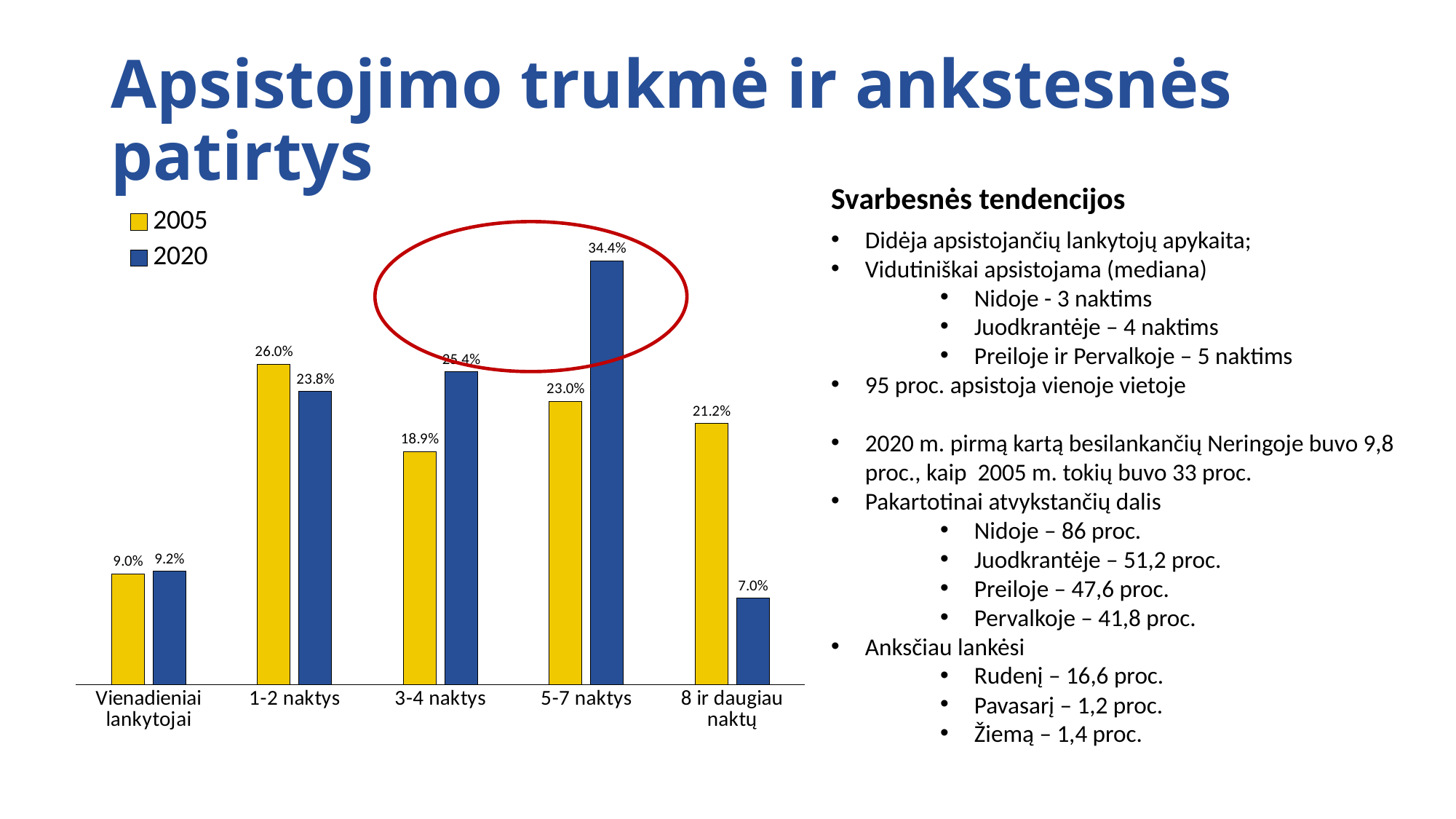
What is the difference between the 2020 and 2005 values for 5-7 naktys? 11.4% What is the 2005 value for 1-2 naktys? 26.0% How many series does the legend list? 2 Which category has the highest 2020 value? 5-7 naktys What is the 2020 value for 8 ir daugiau naktų? 7.0% What is the 2020 value for 5-7 naktys? 34.4% What is the 2005 value for 3-4 naktys? 18.9% Which is larger for 8 ir daugiau naktų, the 2005 value or the 2020 value? 2005 What kind of chart is shown on the slide? Bar chart Which category has the lowest 2005 value? Vienadieniai lankytojai Which colour represents the 2020 series? Blue How many categories are shown on the x axis? 5